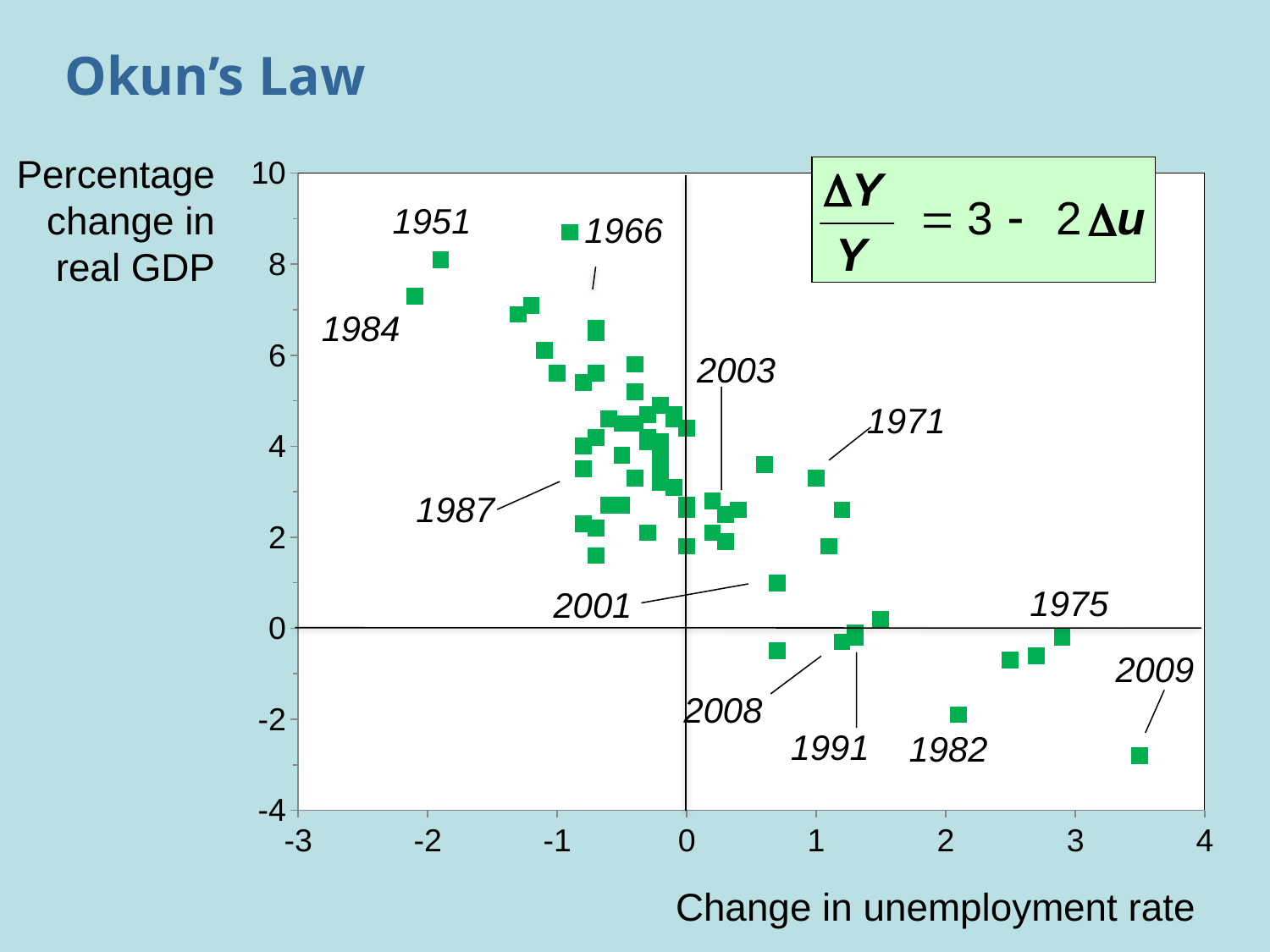
As the change in unemployment rate increases along the x axis, does the percentage change in real GDP generally rise or fall? fall Which labeled year has the higher percentage change in real GDP, 1951 or 1984? 1951 Is the percentage change in real GDP for 2001 greater or less than 2? less What kind of chart is shown on the slide? scatter plot What is the title of the slide containing the chart? Okun's Law Is the percentage change in real GDP for 2009 greater or less than -2? less Is the percentage change in real GDP for 1982 greater or less than -1? less What is the label of the horizontal axis of the chart? Change in unemployment rate Among the labeled years, which has the lowest percentage change in real GDP? 2009